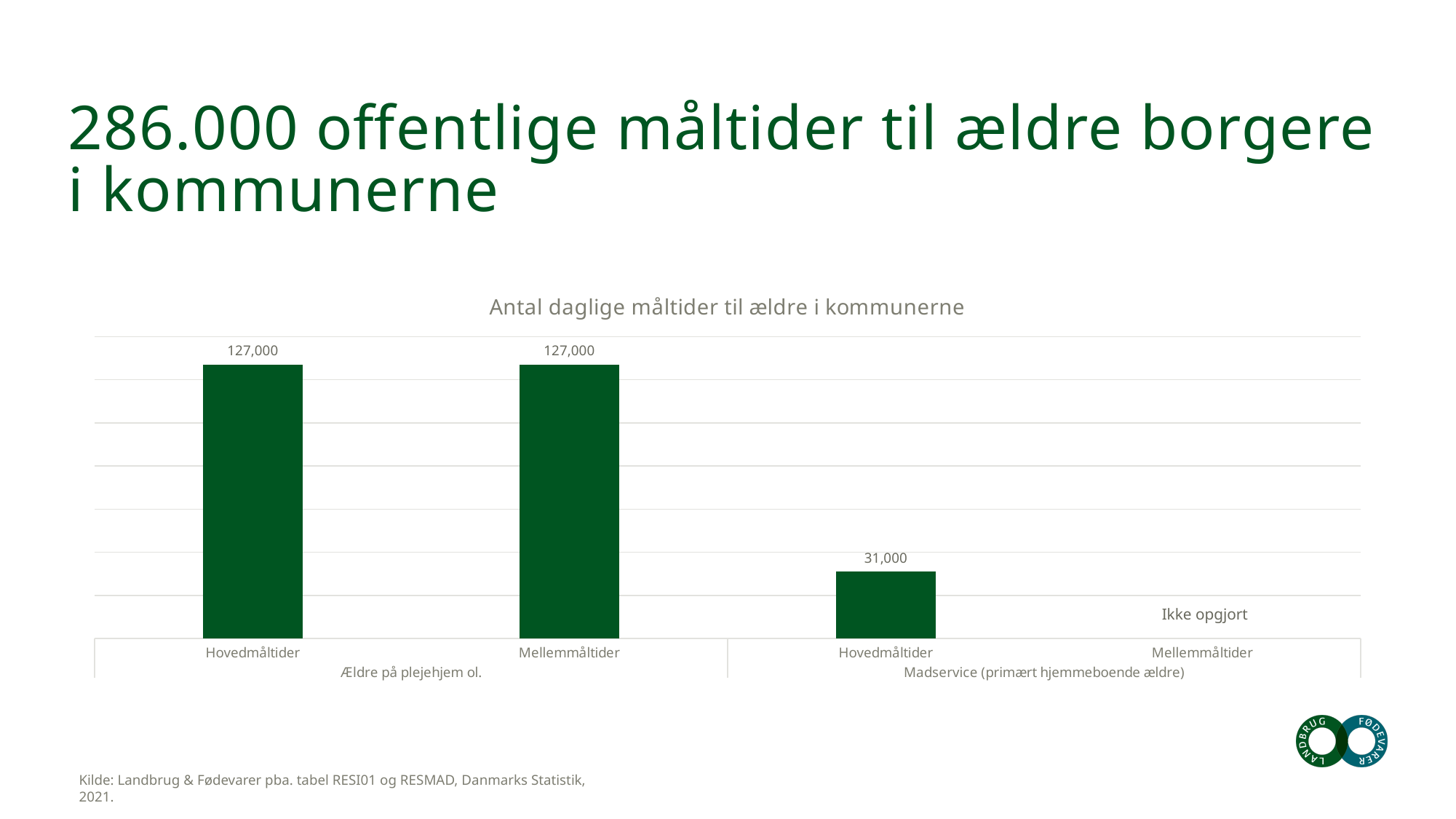
What is the value for Mellemmåltider under Ældre på plejehjem ol.? 127,000 What is the total of the three plotted values in the chart? 285,000 What is the difference between Hovedmåltider under Ældre på plejehjem ol. and Hovedmåltider under Madservice (primært hjemmeboende ældre)? 96,000 How many bars are plotted in the chart? 3 What is the value for Hovedmåltider under Ældre på plejehjem ol.? 127,000 Which category has the lowest plotted value? Hovedmåltider under Madservice (primært hjemmeboende ældre) Which is larger: Hovedmåltider under Ældre på plejehjem ol. or Hovedmåltider under Madservice (primært hjemmeboende ældre)? Hovedmåltider under Ældre på plejehjem ol. What is shown for Mellemmåltider under Madservice (primært hjemmeboende ældre)? Ikke opgjort What is the value for Hovedmåltider under Madservice (primært hjemmeboende ældre)? 31,000 What type of chart is shown on the slide? bar chart How many category groups are shown on the x axis? 2 What is the title of the chart? Antal daglige måltider til ældre i kommunerne